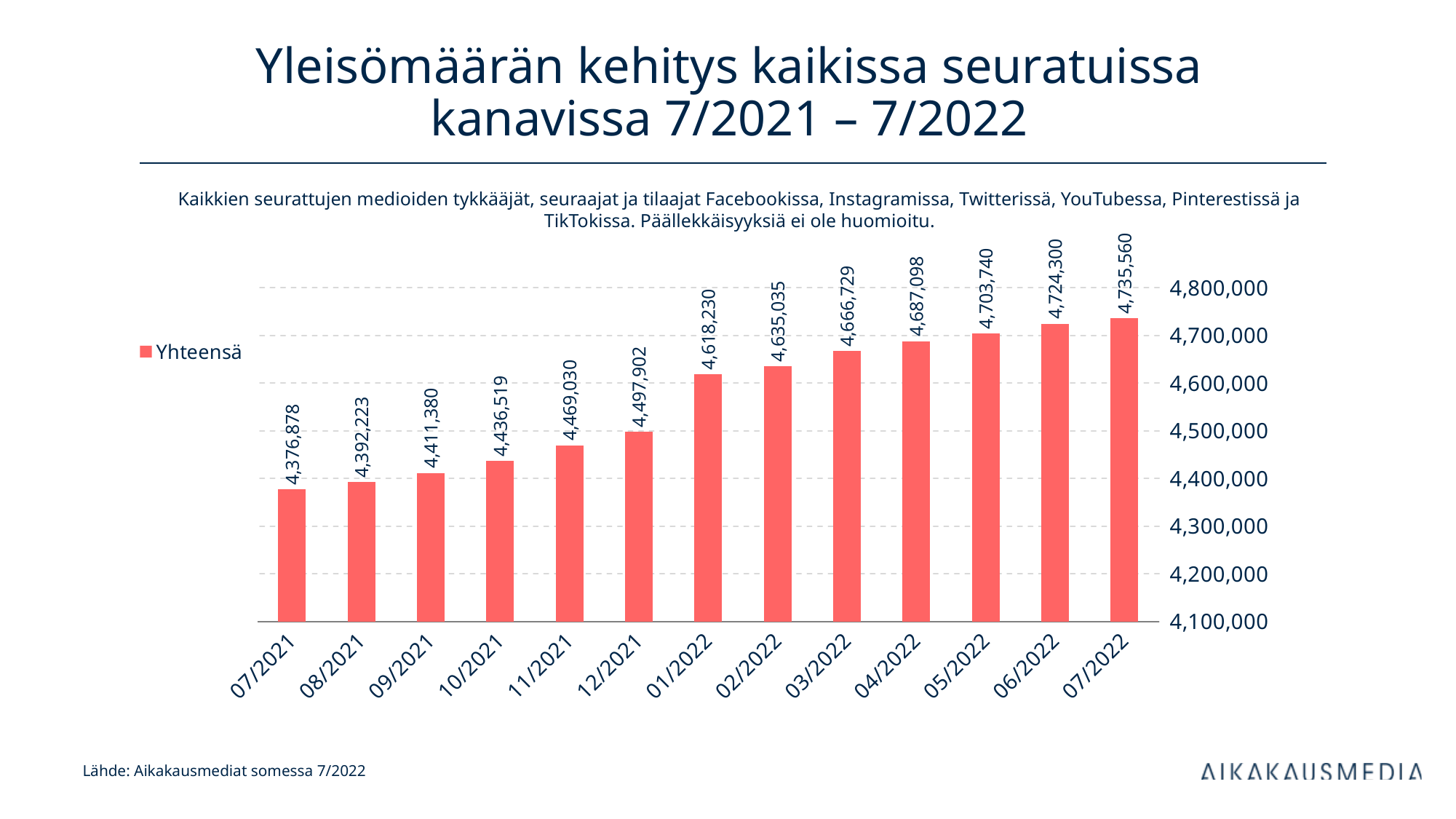
What is the difference between the values for 01/2022 and 12/2021? 120,328 What is the difference between the values for 07/2022 and 07/2021? 358,682 What kind of chart is shown on the slide? bar chart How many months are shown on the x axis? 13 What is the value for 01/2022? 4,618,230 What is the value for 07/2021? 4,376,878 Do the values rise or fall from 07/2021 to 07/2022? rise Which month has the lowest value? 07/2021 Is the value for 12/2021 greater or less than 4,500,000? less Which month has the highest value? 07/2022 What is the value for 07/2022? 4,735,560 Which is larger, the value for 03/2022 or the value for 10/2021? 03/2022